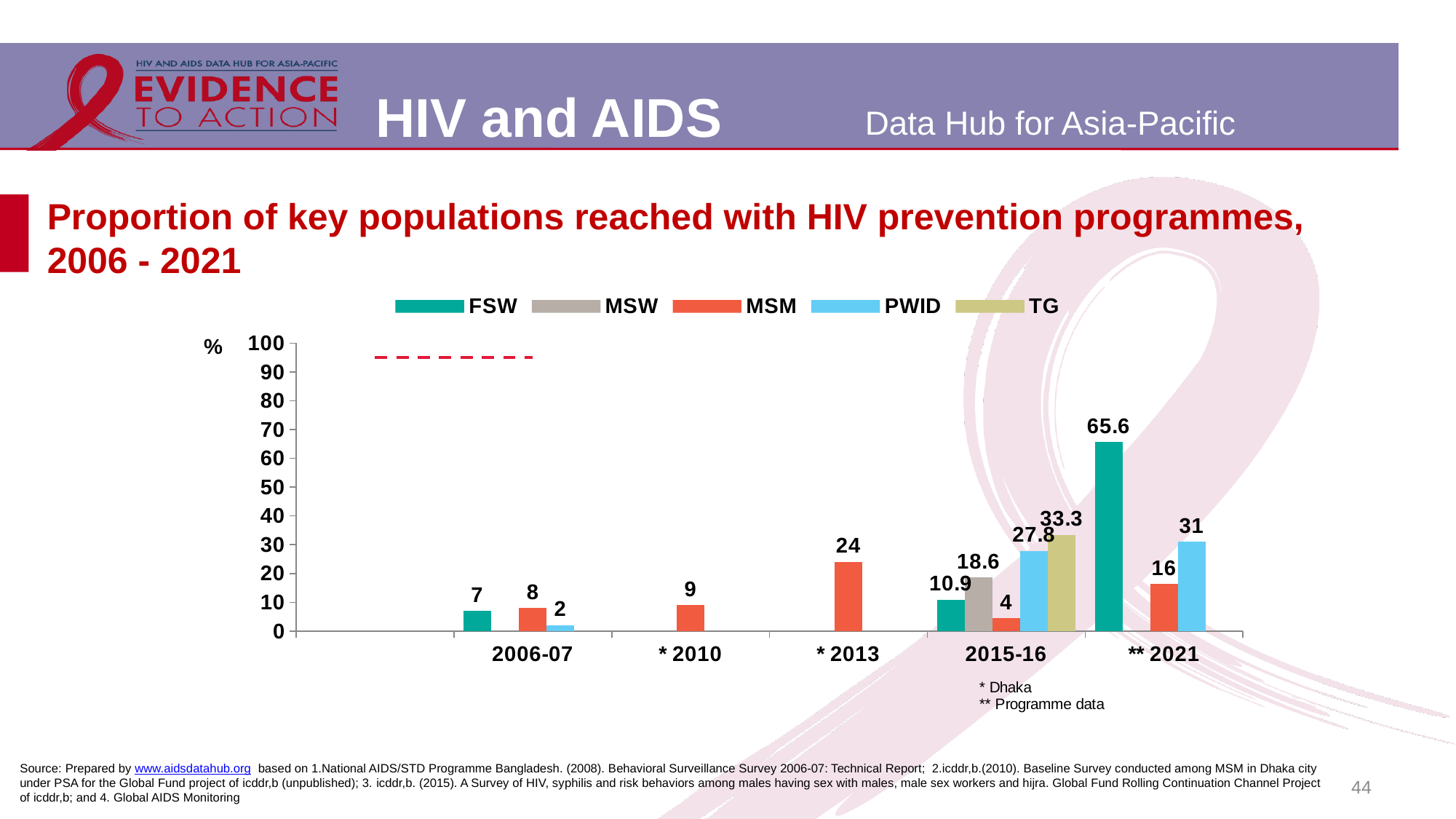
Which series and year has the highest value on the chart? FSW in ** 2021 What is the value for MSW in 2015-16? 18.6 How many year categories are shown on the x axis? 5 What is the value for TG in 2015-16? 33.3 What is the difference between the MSM value in * 2013 and the MSM value in * 2010? 15 What is the value for FSW in ** 2021? 65.6 What kind of chart is shown on the slide? Bar chart What is the value for MSM in * 2013? 24 Which series has the lowest value in 2006-07? PWID Does the MSM value rise or fall from 2006-07 to * 2013? Rise How many series does the legend list? 5 Which is larger: the PWID value in ** 2021 or the TG value in 2015-16? TG in 2015-16